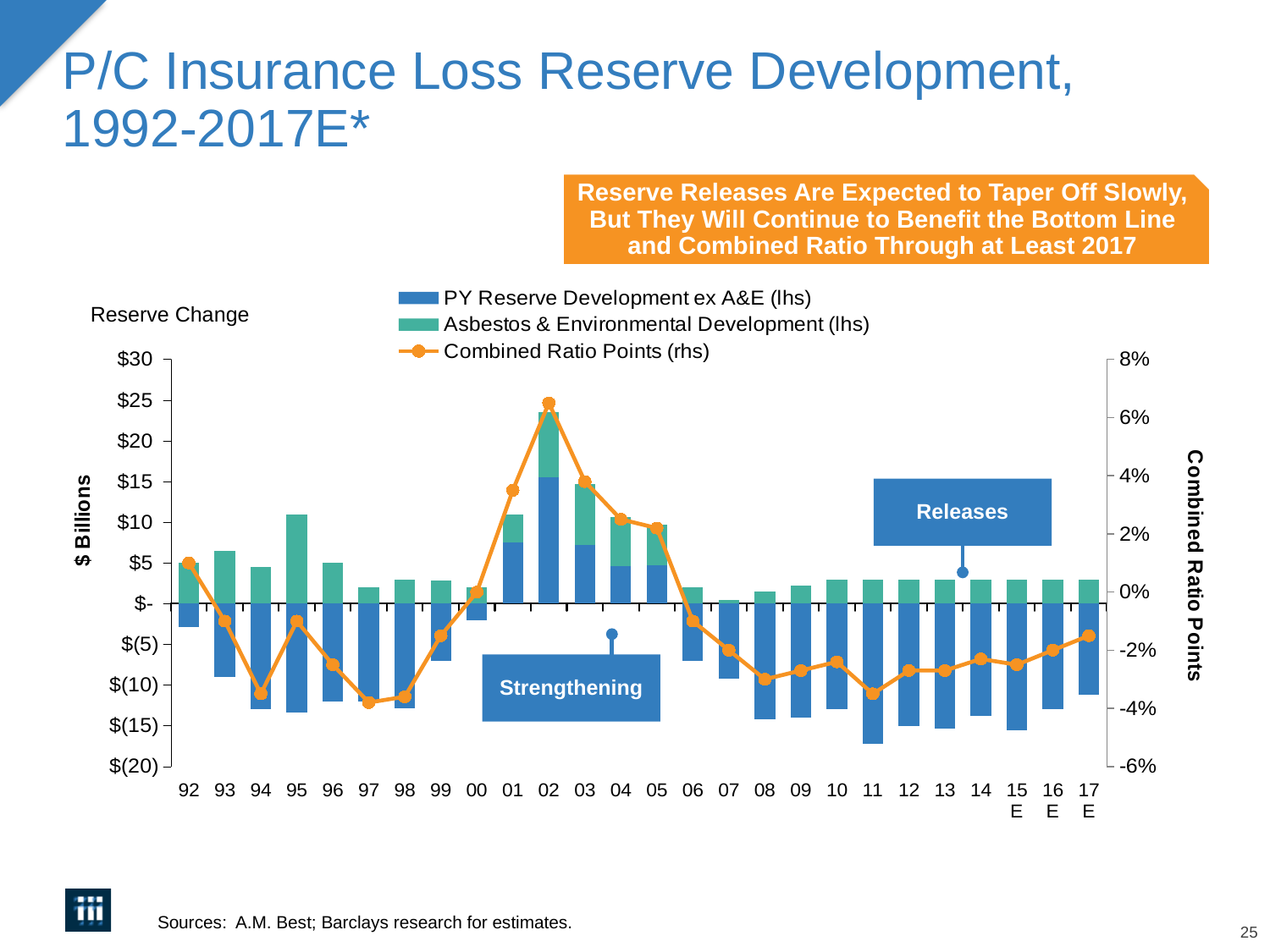
In which year do the Combined Ratio Points reach their highest value? 02 Is the Combined Ratio Points value for 06 greater or less than 0%? less Is the Combined Ratio Points value for 02 greater or less than 4%? greater How many series does the legend list? 3 Is the PY Reserve Development ex A&E value for 02 greater or less than $10 billion? greater In which year is the PY Reserve Development ex A&E bar the highest? 02 Which year has the larger PY Reserve Development ex A&E value, 02 or 03? 02 What are the two annotation labels shown in the boxes on the chart? Strengthening and Releases In which year is the PY Reserve Development ex A&E bar the lowest (most negative)? 11 Do the Combined Ratio Points rise or fall from 97 to 02? rise What kind of chart is shown on the slide? A combination bar and line chart How many years are shown along the x axis? 26